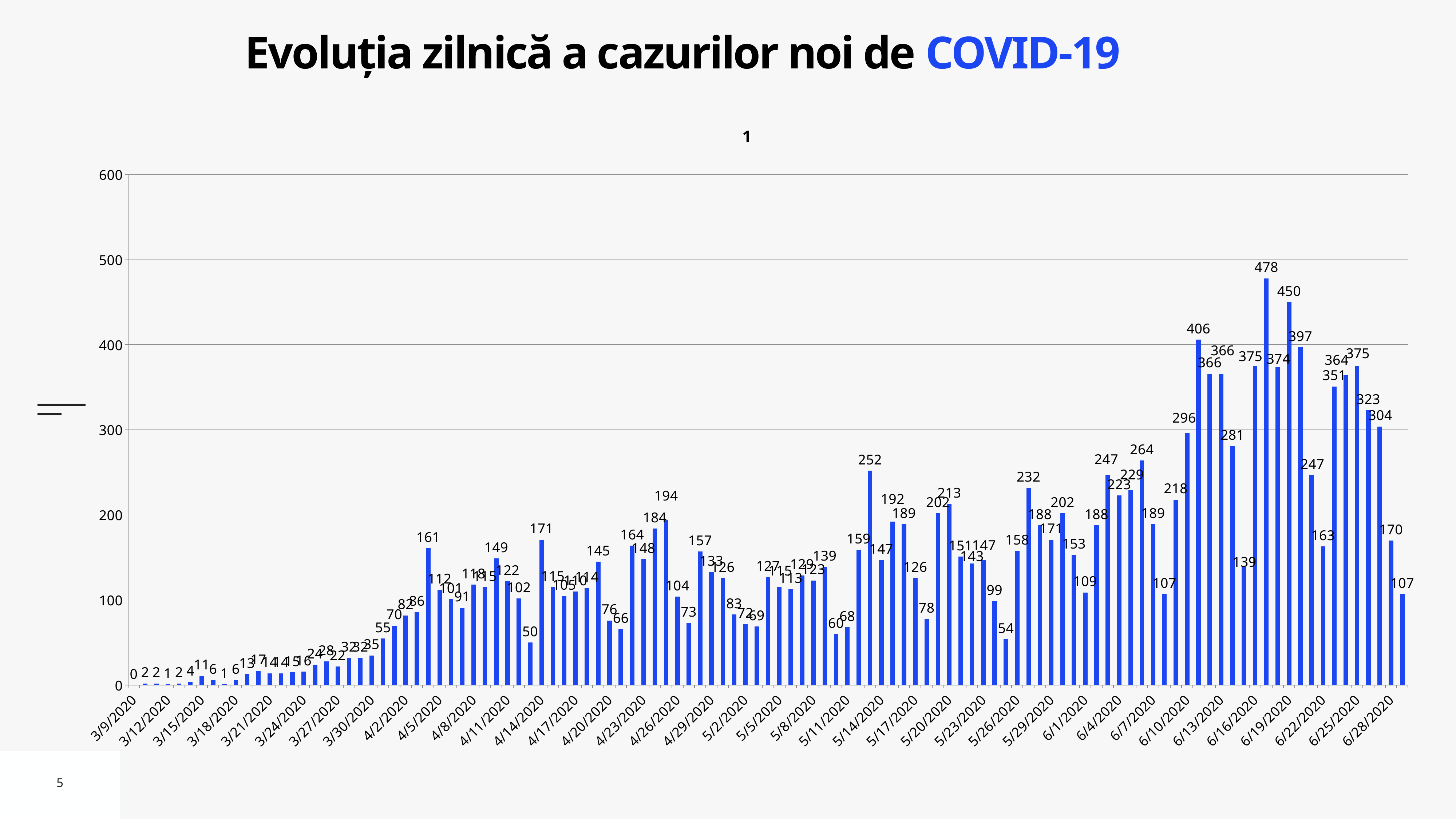
What is the title of the slide? Evoluția zilnică a cazurilor noi de COVID-19 What is the difference between the highest value (478) and the second highest value (450)? 28 What kind of chart is shown on the slide? bar chart Which date has the larger value, 6/16/2020 or 6/19/2020? 6/19/2020 What is the value for 6/10/2020? 296 Is the value for 6/13/2020 greater or less than 300? greater What is the lowest daily value shown in the chart, and on which date does it occur? 0 on 3/9/2020 What is the value for 6/19/2020? 450 What is the highest tick value shown on the y axis? 600 What is the value for 4/14/2020? 171 What is the highest daily value shown in the chart? 478 Overall, do the values rise or fall from March to June along the x axis? rise